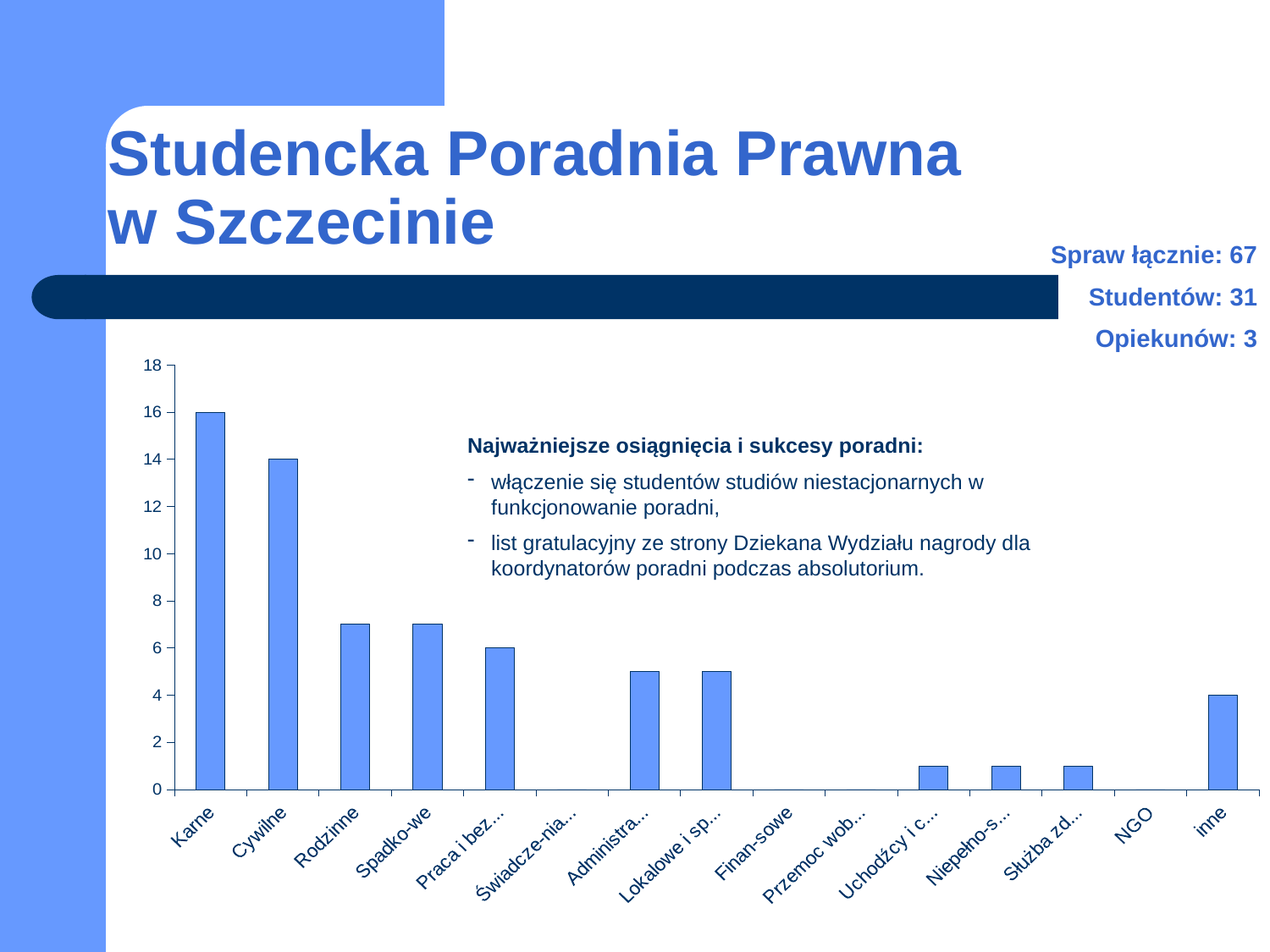
What is the difference between the values for Karne and Cywilne? 2 What kind of chart is shown on the slide? bar chart What is the value for Cywilne? 14 Is the value for Rodzinne greater or less than 8? less What is the value for Karne? 16 Which is larger, the value for Karne or the value for Cywilne? Karne What is the value for Praca i bez...? 6 Is the value for Administra... greater or less than 6? less How many categories are shown on the x axis of the chart? 15 Do the bar values generally rise or fall from left to right along the x axis? fall Which category has the highest value in the chart? Karne What is the value for inne? 4